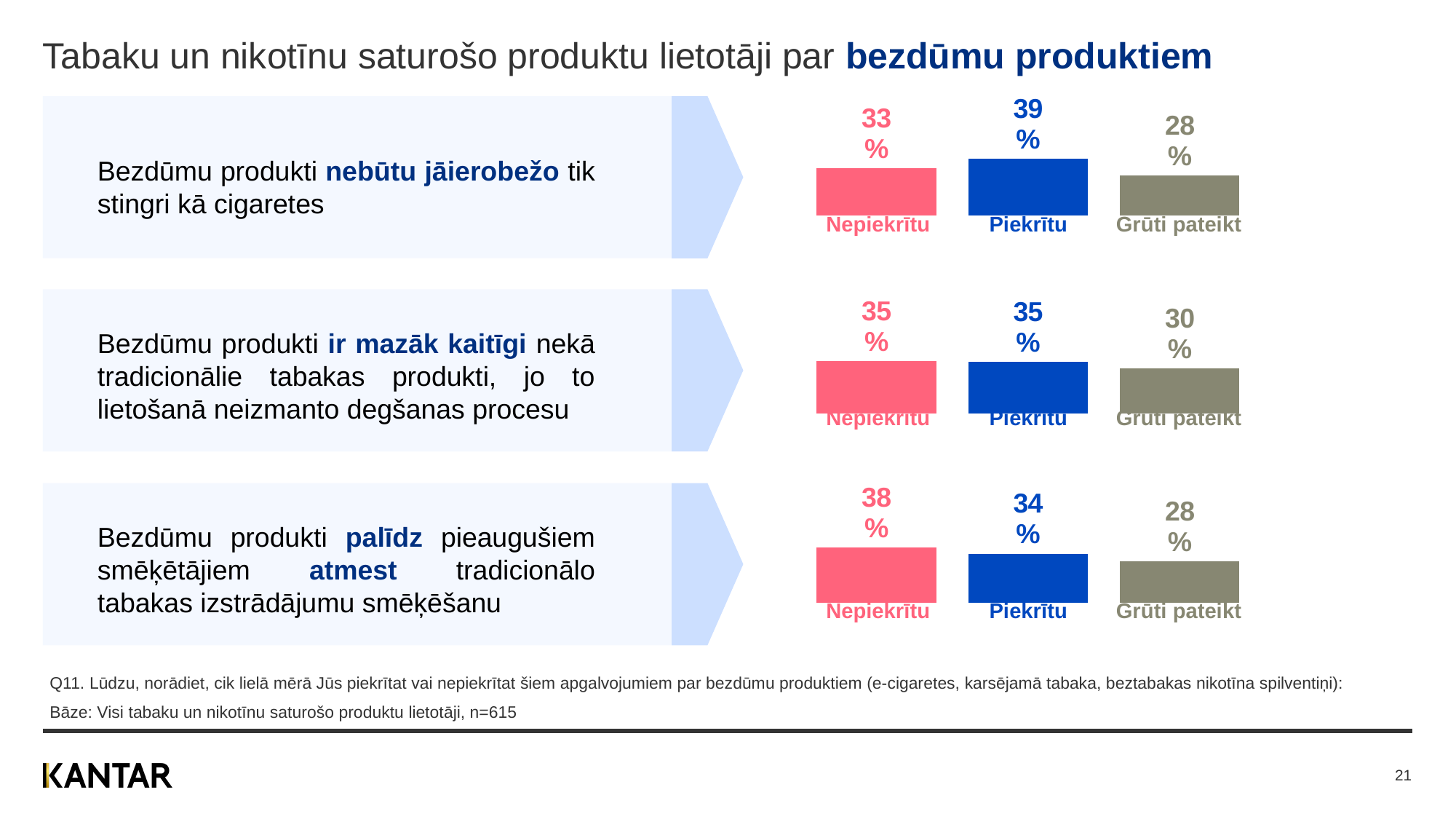
In the top chart (statement 'Bezdūmu produkti nebūtu jāierobežo tik stingri kā cigaretes'), what is the value for Piekrītu? 39% In the middle chart, what is the difference between Piekrītu and Grūti pateikt? 5 percentage points In the top chart, what is the difference between Piekrītu and Nepiekrītu? 6 percentage points What type of chart is used for each statement on the slide? Bar chart In the top chart, which category has the lowest value? Grūti pateikt In the bottom chart, which category has the highest value? Nepiekrītu In the top chart, what is the value for Nepiekrītu? 33% In the middle chart, what is the value for Nepiekrītu? 35% In the middle chart (statement 'Bezdūmu produkti ir mazāk kaitīgi nekā tradicionālie tabakas produkti'), what is the value for Grūti pateikt? 30% How many bars does each of the three charts on the slide have? 3 In the bottom chart, which is larger, Piekrītu or Grūti pateikt? Piekrītu In the bottom chart (statement 'Bezdūmu produkti palīdz pieaugušiem smēķētājiem atmest'), what is the value for Nepiekrītu? 38%